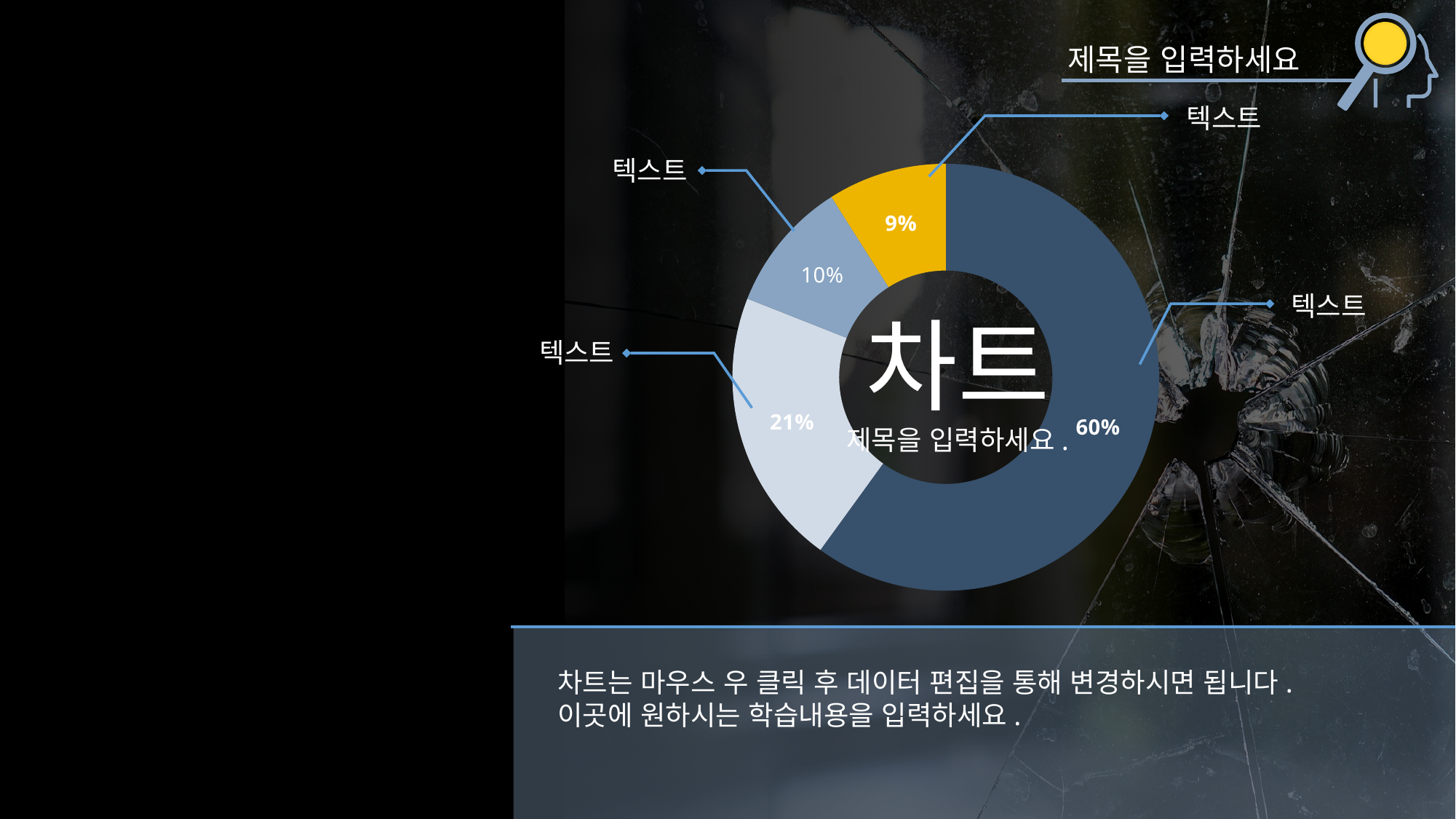
What kind of chart is shown on the slide? doughnut (pie) chart Is the value of the dark blue slice greater or less than 50%? greater What value is labelled on the yellow slice of the doughnut chart? 9% What is the difference between the 21% slice and the 10% slice? 11% What large text is written in the centre of the doughnut chart? 차트 How many slices does the doughnut chart have? 4 What is the smallest percentage shown on the doughnut chart? 9% What value is labelled on the dark blue slice of the doughnut chart? 60% What is the largest percentage shown on the doughnut chart? 60% What value is labelled on the lightest (pale blue) slice of the doughnut chart? 21% Which slice is larger, the yellow slice or the dark blue slice? the dark blue slice What is the difference between the largest slice (60%) and the smallest slice (9%)? 51%